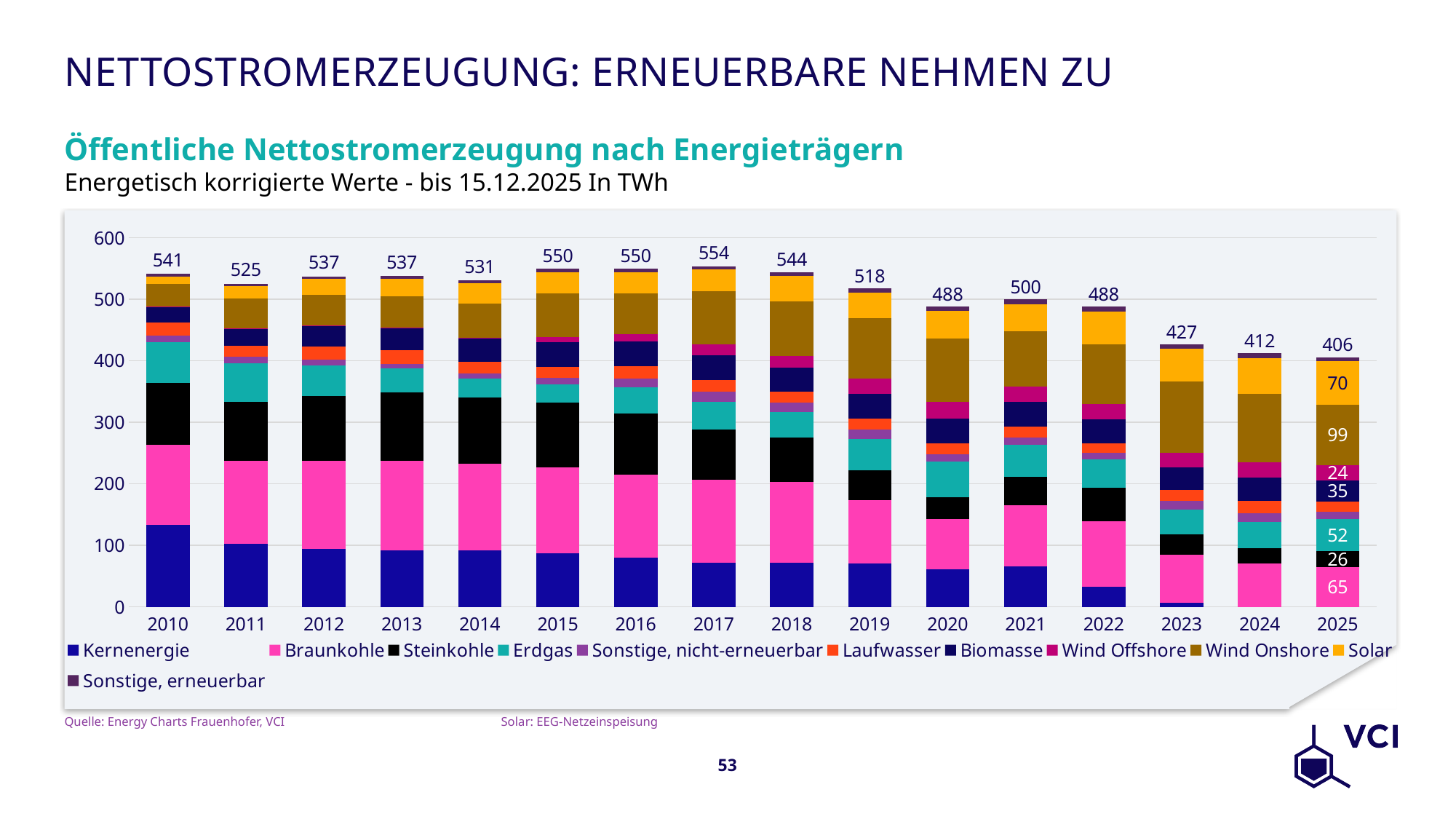
Which year has the larger total, 2019 or 2020? 2019 Is the value for Kernenergie in 2010 greater or less than 100? greater What is the total net electricity generation shown for 2017? 554 What is the total value labelled above the bar for 2025? 406 Which year has the highest total net electricity generation? 2017 Which year has the lowest total net electricity generation? 2025 What is the difference between the total for 2010 and the total for 2025? 135 What value is shown for Solar in 2025? 70 What value is shown for Wind Onshore in 2025? 99 How many years are shown on the x axis? 16 What type of chart is shown on the slide? Stacked bar chart How many series does the legend list? 11